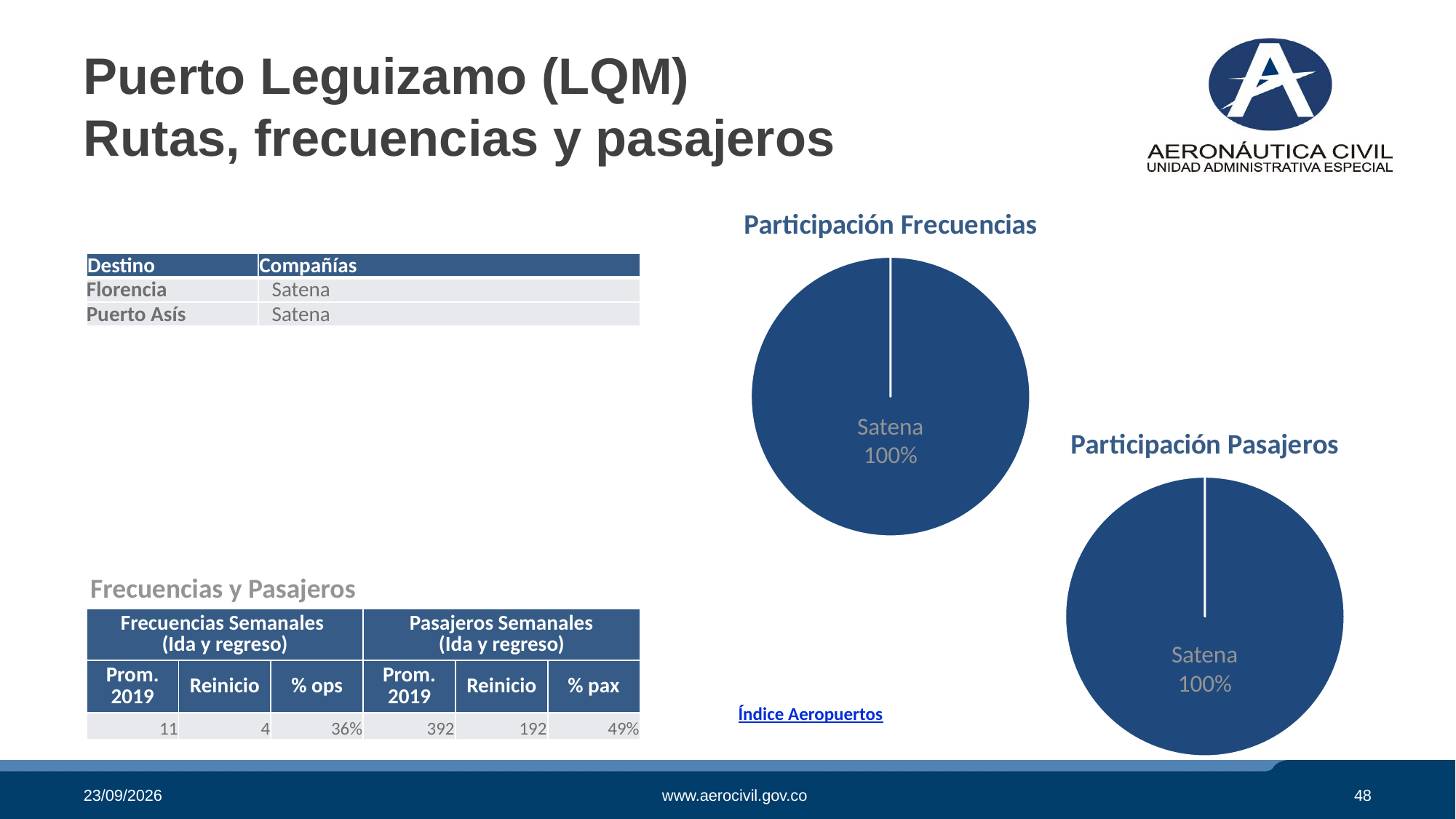
How many slices does the 'Participación Pasajeros' pie chart have? 1 What kind of chart is 'Participación Frecuencias'? Pie chart What is the title of the pie chart positioned at the lower right of the slide? Participación Pasajeros Which company is shown in the 'Participación Pasajeros' chart? Satena What is the title of the pie chart positioned at the upper right of the slide? Participación Frecuencias In the 'Participación Frecuencias' chart, what share does Satena hold? 100% Which company is shown in the 'Participación Frecuencias' chart? Satena How many slices does the 'Participación Frecuencias' pie chart have? 1 Is Satena's share in the 'Participación Pasajeros' chart greater or less than 50%? greater What kind of chart is 'Participación Pasajeros'? Pie chart In the 'Participación Pasajeros' chart, what share does Satena hold? 100%